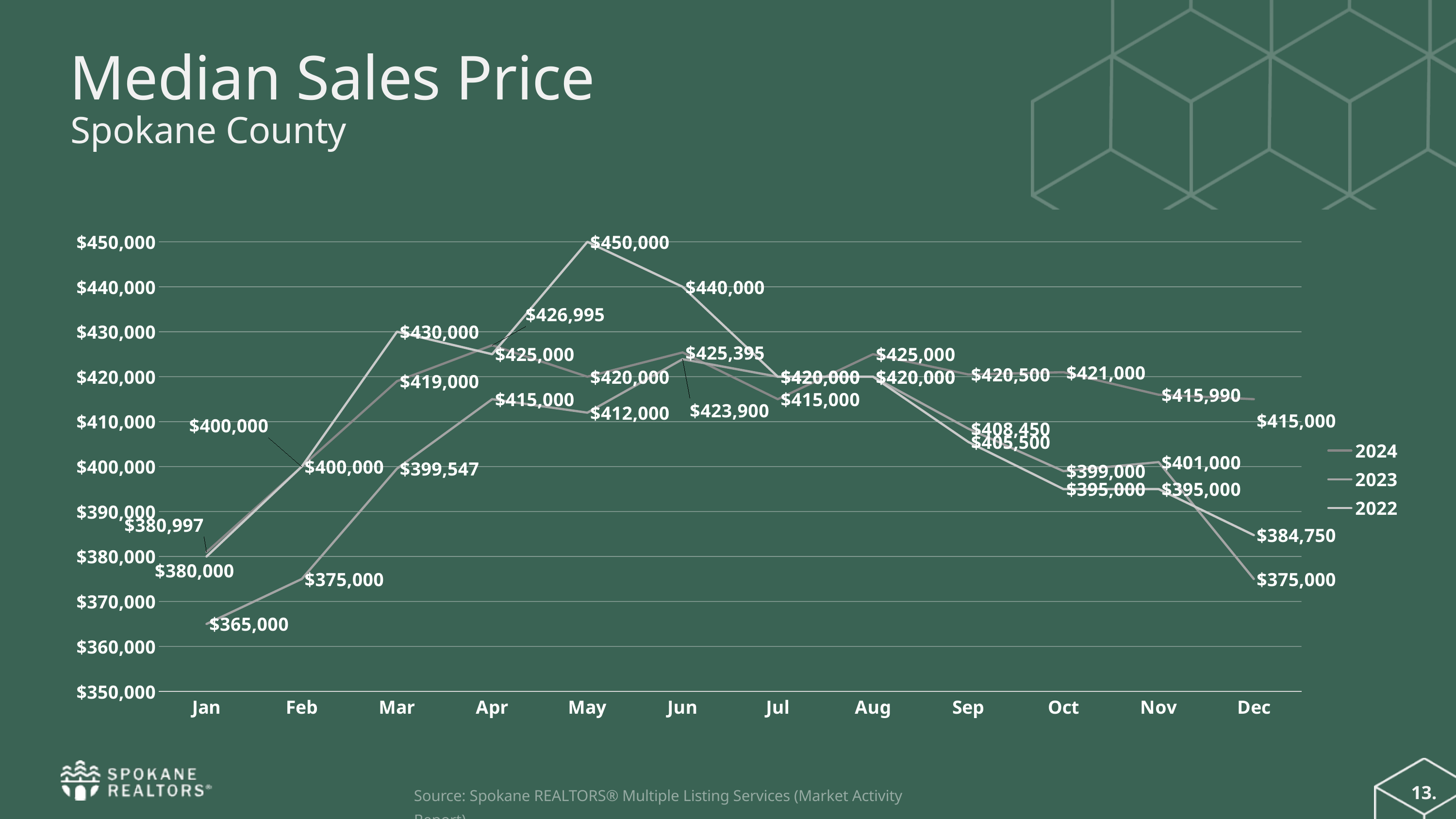
In which month does the highest labeled value on the chart occur? May What is the lowest value labeled anywhere on the chart? $365,000 What are the entries in the chart's legend? 2024, 2023, 2022 What kind of chart is shown on the slide? line chart What is the difference between the highest and lowest values labeled for May? $38,000 What is the highest value labeled for Dec? $415,000 How many months are shown along the x axis? 12 What is the difference between the highest and lowest values labeled for Dec? $40,000 What is the lowest value labeled for Dec? $375,000 What is the highest value labeled anywhere on the chart? $450,000 How many series does the legend list? 3 In which month does the lowest labeled value on the chart occur? Jan